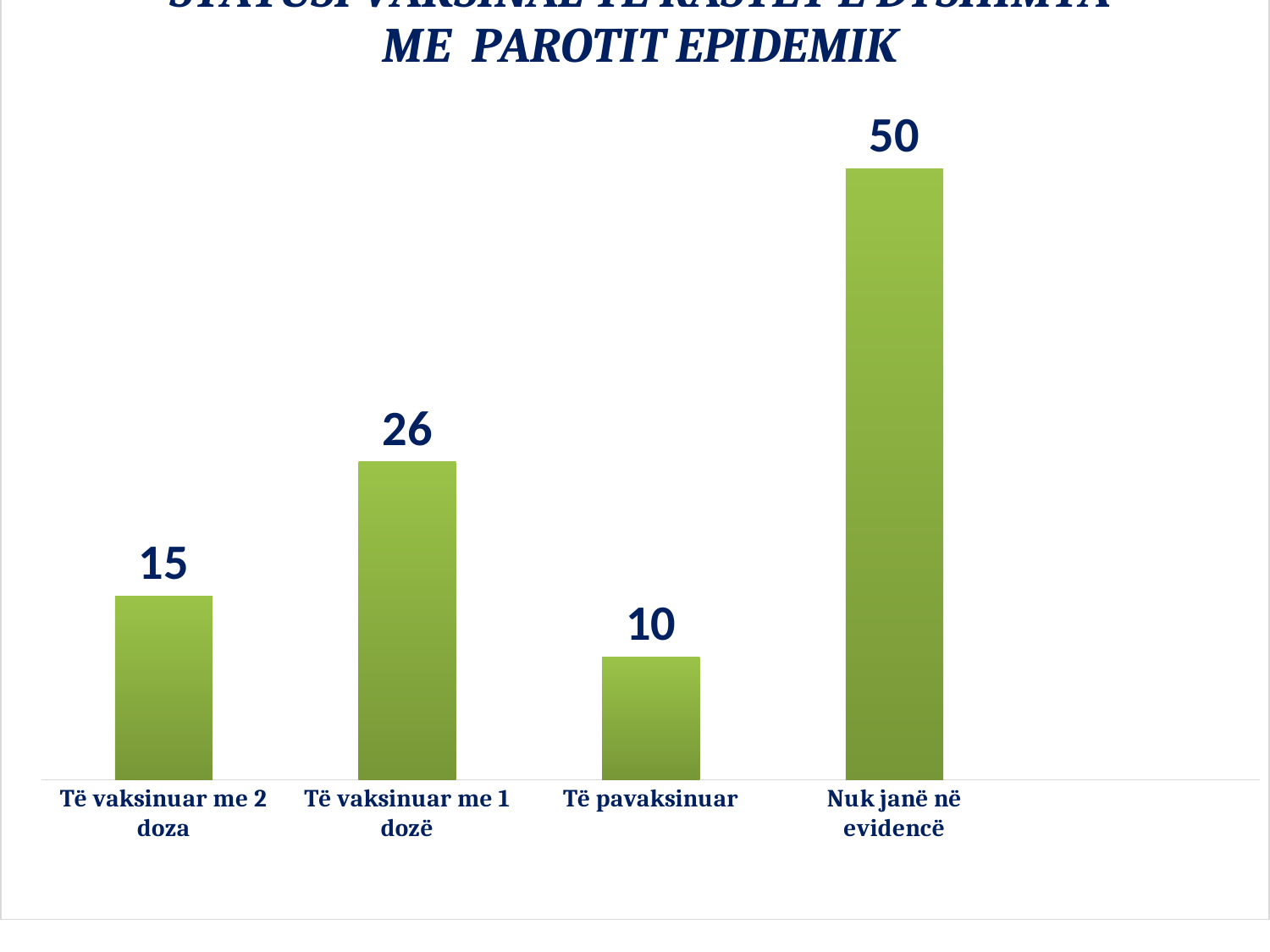
What is the value for "Të vaksinuar me 2 doza"? 15 What is the difference between the values for "Të vaksinuar me 2 doza" and "Të pavaksinuar"? 5 Which is larger, the value for "Të vaksinuar me 1 dozë" or the value for "Të vaksinuar me 2 doza"? Të vaksinuar me 1 dozë What is the value for "Të pavaksinuar"? 10 What is the value for "Nuk janë në evidencë"? 50 What kind of chart is shown on the slide? Bar chart Which category has the highest value? Nuk janë në evidencë What is the value for "Të vaksinuar me 1 dozë"? 26 How many categories are shown in the chart? 4 Which category has the lowest value? Të pavaksinuar What is the difference between the values for "Nuk janë në evidencë" and "Të vaksinuar me 1 dozë"? 24 What colour are the bars in the chart? Green